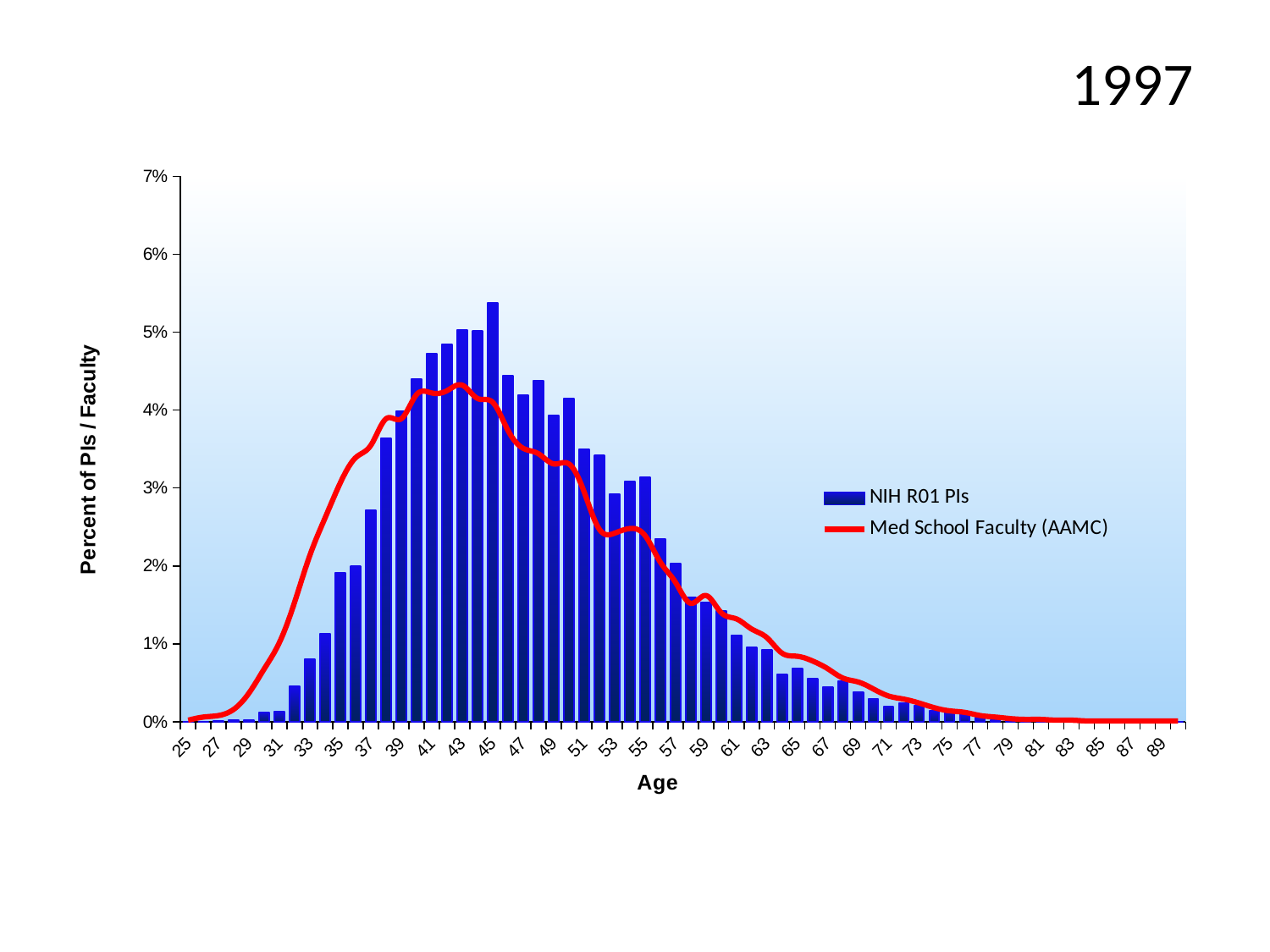
How many series does the legend list? 2 Is the NIH R01 PIs value at age 41 greater or less than 4%? greater At which age is the NIH R01 PIs bar highest? 45 At age 45, which is larger: the NIH R01 PIs bar or the Med School Faculty (AAMC) line? NIH R01 PIs Is the NIH R01 PIs value at age 45 greater or less than 5%? greater At age 33, which is larger: the NIH R01 PIs bar or the Med School Faculty (AAMC) line? Med School Faculty (AAMC) What is the title of the vertical axis? Percent of PIs / Faculty Is the NIH R01 PIs value at age 65 greater or less than 1%? less Do the NIH R01 PIs values generally rise or fall from age 45 to age 65? fall What are the two series named in the legend? NIH R01 PIs; Med School Faculty (AAMC)